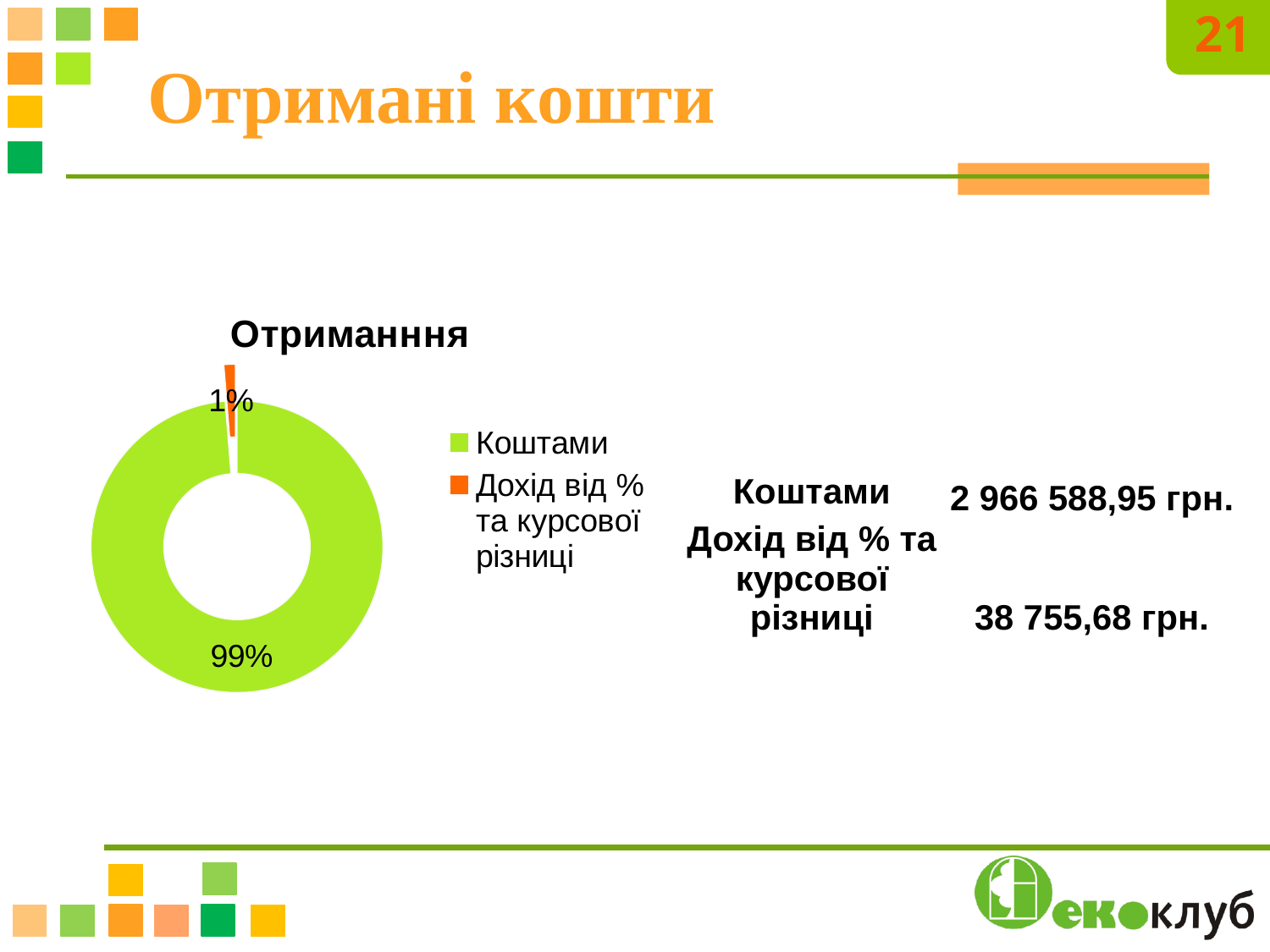
Which category has the largest share of the chart? Коштами What is the difference in percentage points between the 'Коштами' share and the 'Дохід від % та курсової різниці' share? 98% How many entries does the legend list? 2 What is the title of the chart? Отриманння What percentage share does the 'Коштами' slice have? 99% What percentage share does the 'Дохід від % та курсової різниці' slice have? 1% Which is larger: the share for 'Коштами' or the share for 'Дохід від % та курсової різниці'? Коштами What type of chart is shown on the slide? Doughnut (pie) chart Which category has the smallest share of the chart? Дохід від % та курсової різниці What colour represents 'Коштами' in the chart? Green How many categories does the chart show? 2